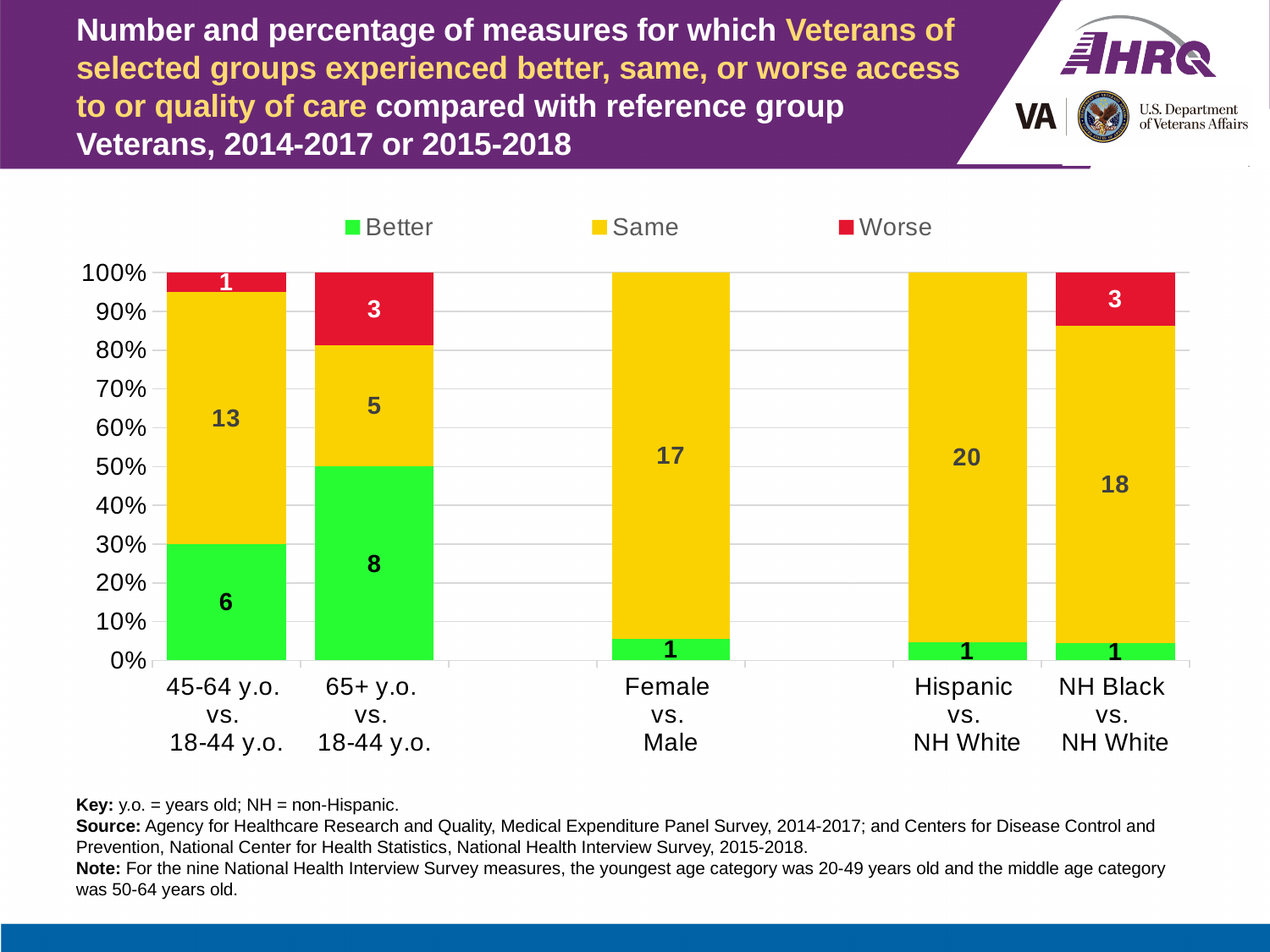
Which is larger: the 'Better' count for 45-64 y.o. vs. 18-44 y.o. or the 'Better' count for Female vs. Male? 45-64 y.o. vs. 18-44 y.o. Which group has the highest number of 'Same' measures? Hispanic vs. NH White What is the total number of measures for 45-64 y.o. vs. 18-44 y.o. (Better + Same + Worse)? 20 What type of chart is shown on the slide? Stacked bar chart How many measures were 'Better' for 65+ y.o. vs. 18-44 y.o.? 8 How many series does the legend list? 3 What is the total number of measures for NH Black vs. NH White (Better + Same + Worse)? 22 How many measures were 'Same' for Hispanic vs. NH White? 20 How many measures were 'Worse' for NH Black vs. NH White? 3 How many measures were 'Same' for Female vs. Male? 17 What is the difference between the 'Same' counts for Hispanic vs. NH White and 65+ y.o. vs. 18-44 y.o.? 15 Which group has the highest number of 'Better' measures? 65+ y.o. vs. 18-44 y.o.